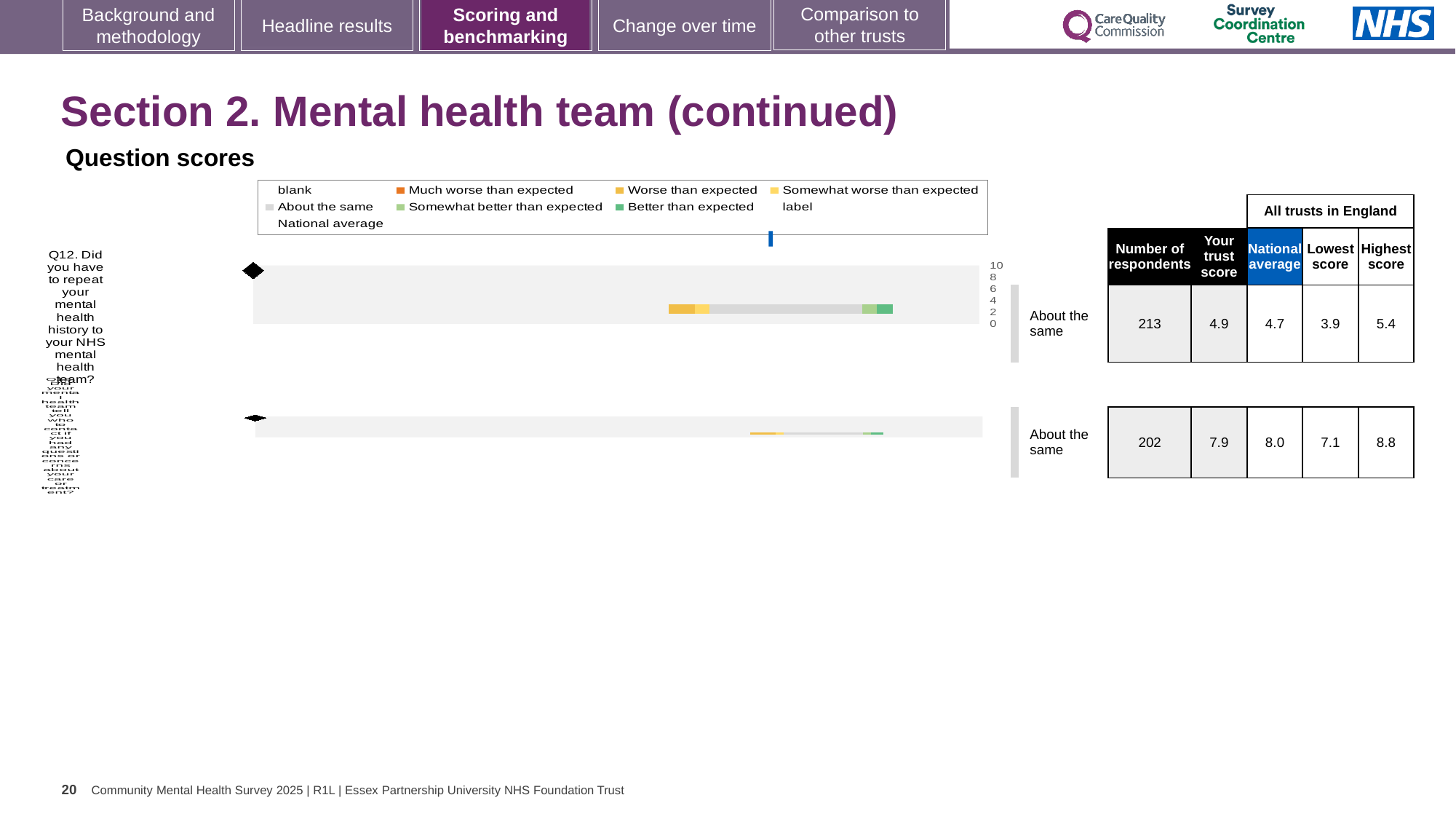
For the lower chart on the slide, what is the trust's score? 7.9 For Q12, which is larger: the trust's score or the national average? the trust's score For Q12, what is the national average score? 4.7 For the lower chart on the slide, which is larger: the trust's score or the national average? the national average For Q12, what is the difference between the trust's score and the national average? 0.2 What is the maximum value shown on the score axis of the charts? 10 For Q12 (repeating your mental health history), what is the trust's score? 4.9 What kind of chart is used to show the Q12 benchmarking result? bar chart For the lower chart on the slide, what is the highest score among all trusts in England? 8.8 For the lower chart on the slide, how many respondents are there? 202 How many respondents answered Q12? 213 Which benchmark category is Q12 placed in? About the same